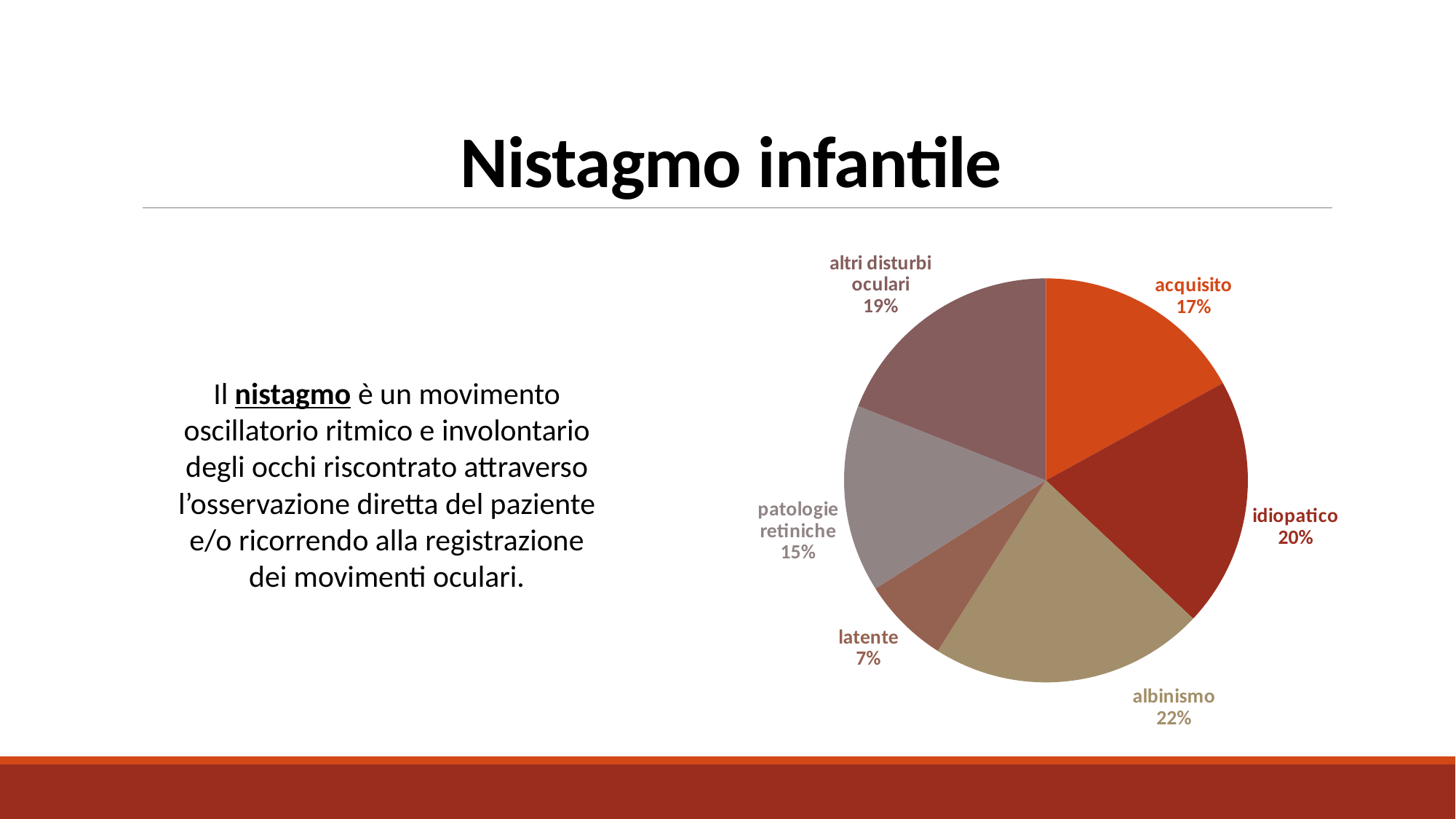
What is the title of the slide containing the pie chart? Nistagmo infantile Which category has the largest slice of the pie? albinismo What kind of chart is shown on the slide? pie chart How many categories are shown in the pie chart? 6 What is the difference between the albinismo and patologie retiniche shares? 7% What is the value shown for idiopatico? 20% Which category has the smallest slice of the pie? latente What is the difference between the idiopatico and latente shares? 13% What is the value shown for patologie retiniche? 15% What share of the pie does albinismo have? 22% What is the value shown for acquisito? 17% Which is larger, the share for altri disturbi oculari or the share for acquisito? altri disturbi oculari